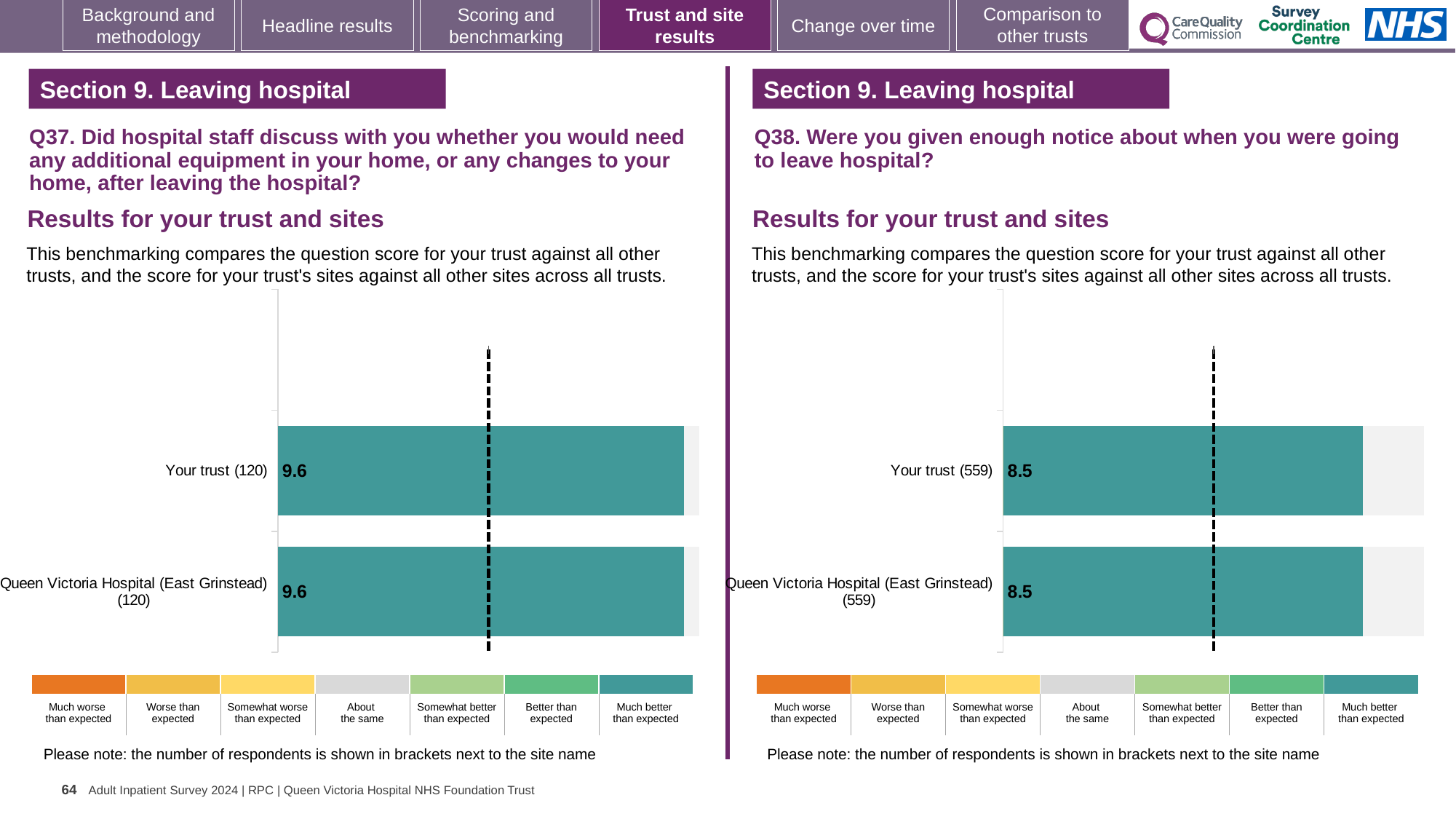
How many bars are plotted on the Q37 chart (left)? 2 On the Q38 chart (right), what is the score for Your trust? 8.5 Is the score for Your trust on the Q37 chart (left) larger or smaller than the score for Your trust on the Q38 chart (right)? Larger How many bars are plotted on the Q38 chart (right)? 2 On the Q37 chart (left), what is the difference between the score for Your trust and the score for Queen Victoria Hospital (East Grinstead)? 0 What kind of chart is the Q38 chart (right)? Bar chart On the Q38 chart (right), what is the score for Queen Victoria Hospital (East Grinstead)? 8.5 On the Q38 chart (right), what is the difference between the score for Your trust and the score for Queen Victoria Hospital (East Grinstead)? 0 On the Q37 chart (left), what is the score for Queen Victoria Hospital (East Grinstead)? 9.6 On the Q37 chart (left), how many respondents are shown in brackets next to Your trust? 120 On the Q38 chart (right), how many respondents are shown in brackets next to Queen Victoria Hospital (East Grinstead)? 559 On the Q37 chart (left), what is the score for Your trust? 9.6